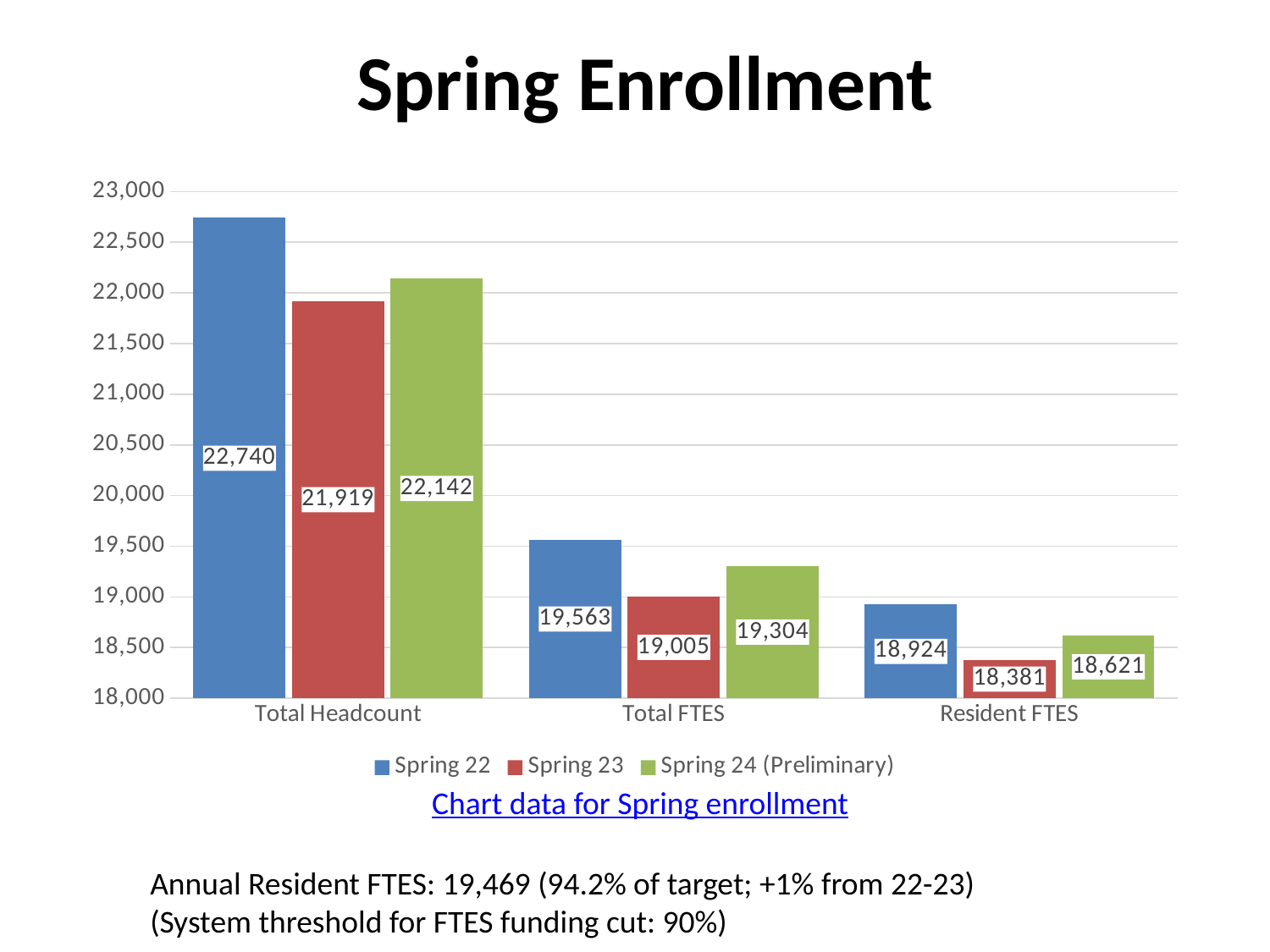
What is the Spring 22 value for Total Headcount? 22,740 How many series does the legend list? 3 Which series has the highest value for Total Headcount? Spring 22 What kind of chart is shown on the slide? bar chart How many categories are shown on the x axis? 3 Which series has the lowest value for Resident FTES? Spring 23 What is the Spring 23 value for Total FTES? 19,005 Which is larger: the Spring 24 (Preliminary) value for Total FTES or the Spring 22 value for Total FTES? Spring 22 What is the difference between the Spring 22 and Spring 23 values for Total Headcount? 821 What is the difference between the Spring 24 (Preliminary) and Spring 23 values for Total FTES? 299 Is the Spring 23 value for Total Headcount greater or less than 22,000? less What is the Spring 24 (Preliminary) value for Resident FTES? 18,621